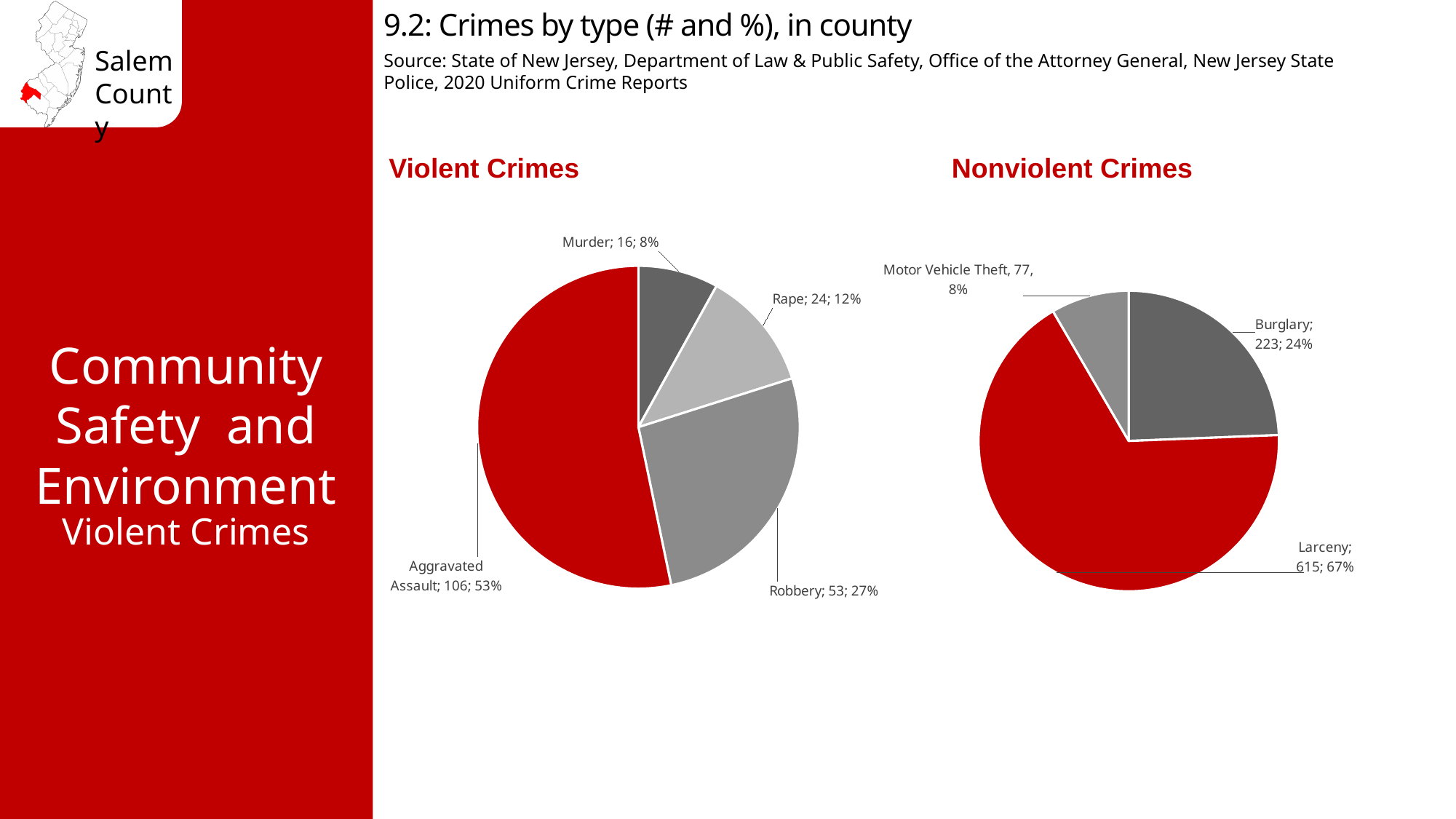
In the Violent Crimes pie chart, how many crime types are shown? 4 In the Nonviolent Crimes pie chart, what is the difference between the Burglary count and the Motor Vehicle Theft count? 146 In the Violent Crimes pie chart, which crime type has the smallest count? Murder In the Violent Crimes pie chart, what percentage share does Robbery have? 27% What type of chart is used for the Nonviolent Crimes data? Pie chart In the Nonviolent Crimes pie chart, what percentage share does Burglary have? 24% In the Nonviolent Crimes pie chart, how many larcenies are shown? 615 In the Violent Crimes pie chart, what is the difference between the Robbery count and the Rape count? 29 In the Violent Crimes pie chart, how many aggravated assaults are shown? 106 In the Nonviolent Crimes pie chart, which crime type has the smallest count? Motor Vehicle Theft In the Violent Crimes pie chart, which crime type has the largest count? Aggravated Assault Which is larger: the Rape count in the Violent Crimes chart or the Motor Vehicle Theft count in the Nonviolent Crimes chart? Motor Vehicle Theft